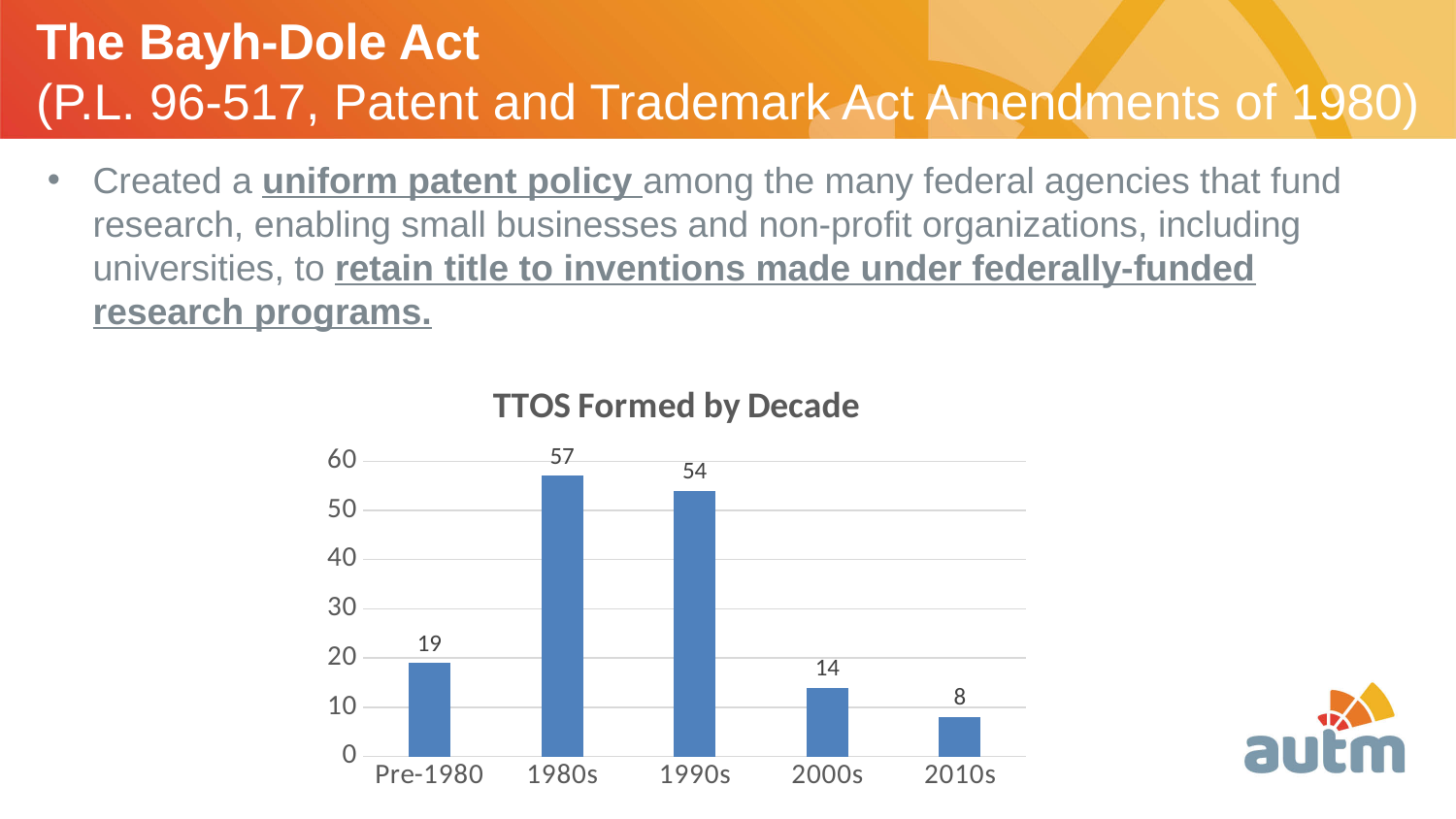
What is the difference between the values for Pre-1980 and the 2010s? 11 What is the title of the chart on the slide? TTOS Formed by Decade How many decade categories are shown on the x axis of the chart? 5 What kind of chart is used to show TTOS Formed by Decade? Bar chart Which decade has the highest number of TTOs formed? 1980s Which decade has the lowest number of TTOs formed? 2010s What is the value for Pre-1980 in the chart? 19 What is the value for the 1980s in the TTOS Formed by Decade chart? 57 Do the values rise or fall from the 1980s to the 2010s? Fall What is the difference between the values for the 1980s and the 1990s? 3 How many TTOs were formed in the 2000s according to the chart? 14 Which is larger, the value for Pre-1980 or the value for the 2000s? Pre-1980